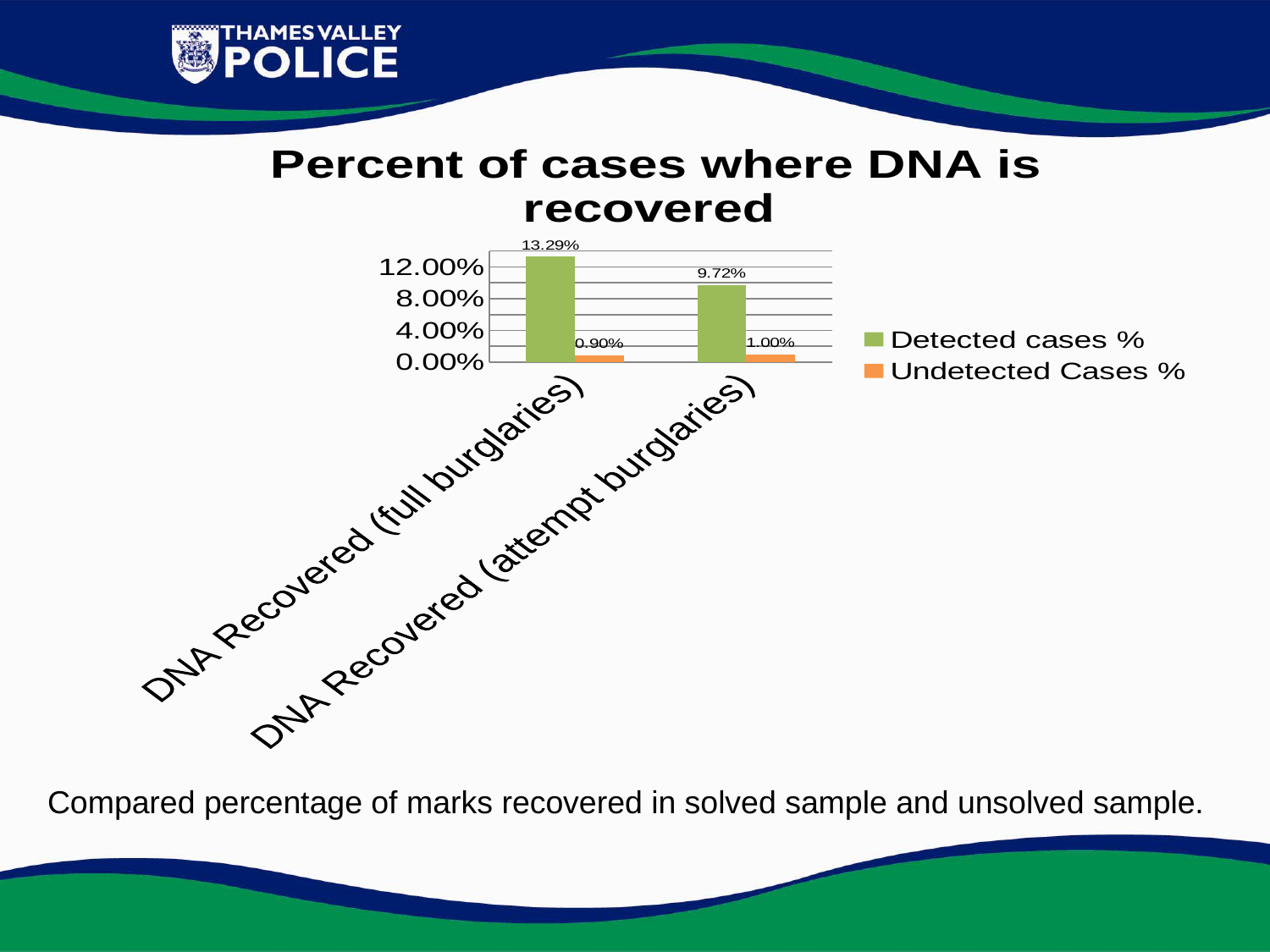
Which category has the lowest Undetected Cases % value? DNA Recovered (full burglaries) How many categories are shown on the x axis? 2 What is the difference between the Detected cases % values for full burglaries and attempt burglaries? 3.57% What is the Detected cases % value for DNA Recovered (attempt burglaries)? 9.72% For DNA Recovered (full burglaries), which is larger: Detected cases % or Undetected Cases %? Detected cases % How many series does the legend list? 2 What is the Detected cases % value for DNA Recovered (full burglaries)? 13.29% Which category has the highest Detected cases % value? DNA Recovered (full burglaries) For DNA Recovered (attempt burglaries), what is the difference between the Detected cases % and Undetected Cases % values? 8.72% What is the Undetected Cases % value for DNA Recovered (attempt burglaries)? 1.00% What is the Undetected Cases % value for DNA Recovered (full burglaries)? 0.90% What type of chart is shown on the slide? Bar chart